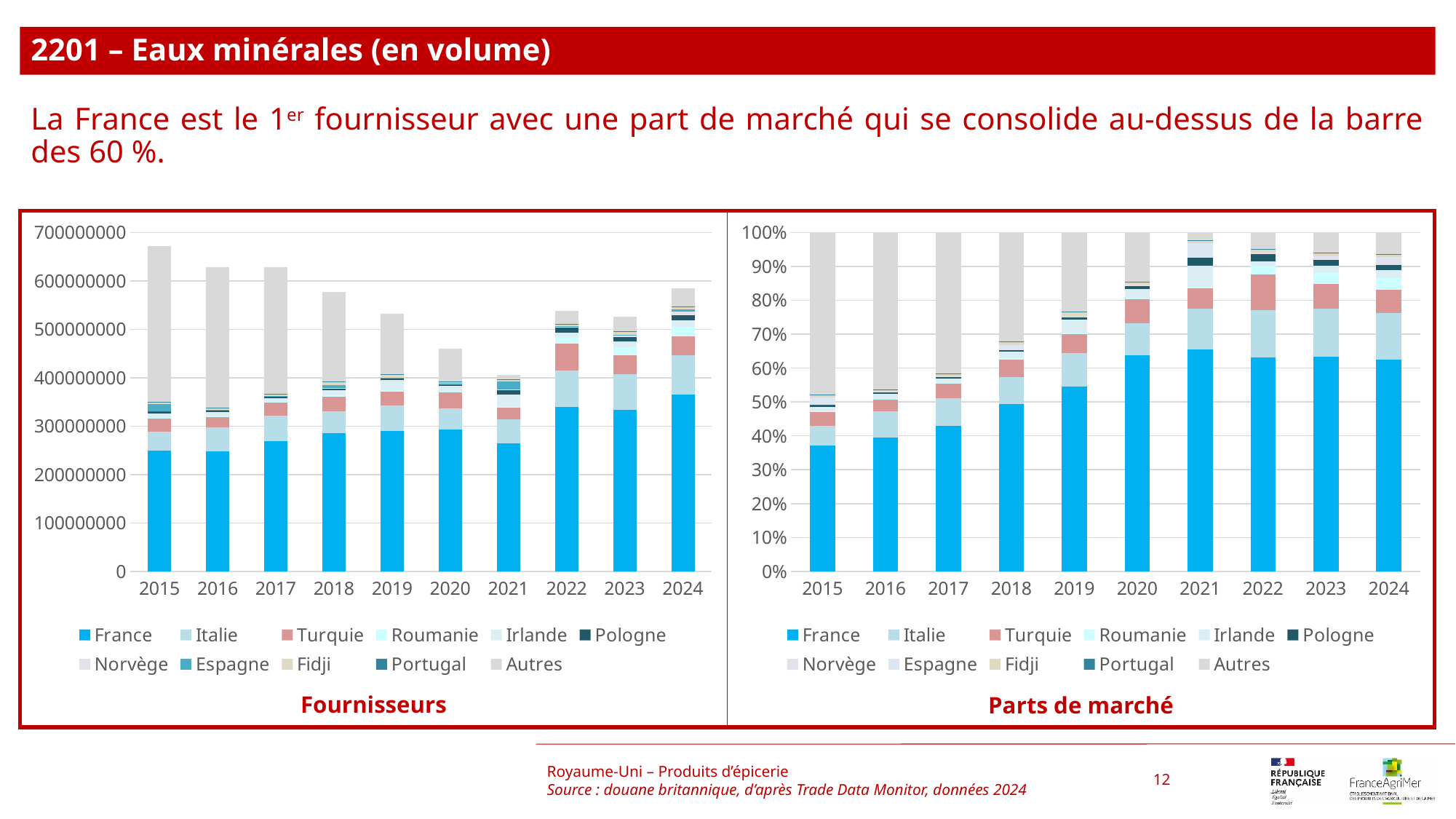
What kind of chart is the 'Fournisseurs' chart on the left? stacked bar chart In the 'Fournisseurs' chart, is the total stacked bar for 2020 greater or less than 500000000? less In the 'Fournisseurs' chart, is the total stacked bar for 2015 greater or less than 600000000? greater In the 'Fournisseurs' chart, is the value for France in 2024 greater or less than 300000000? greater In the 'Fournisseurs' chart, which year has the lowest total stacked bar? 2021 How many years are shown on the x axis of the 'Parts de marché' chart? 10 How many series does the legend of the 'Fournisseurs' chart list? 11 In the 'Parts de marché' chart, does the share for France generally rise or fall from 2015 to 2024? rise In the 'Fournisseurs' chart, which year has the highest total stacked bar? 2015 In the 'Fournisseurs' chart, is the value for France larger in 2015 or in 2024? 2024